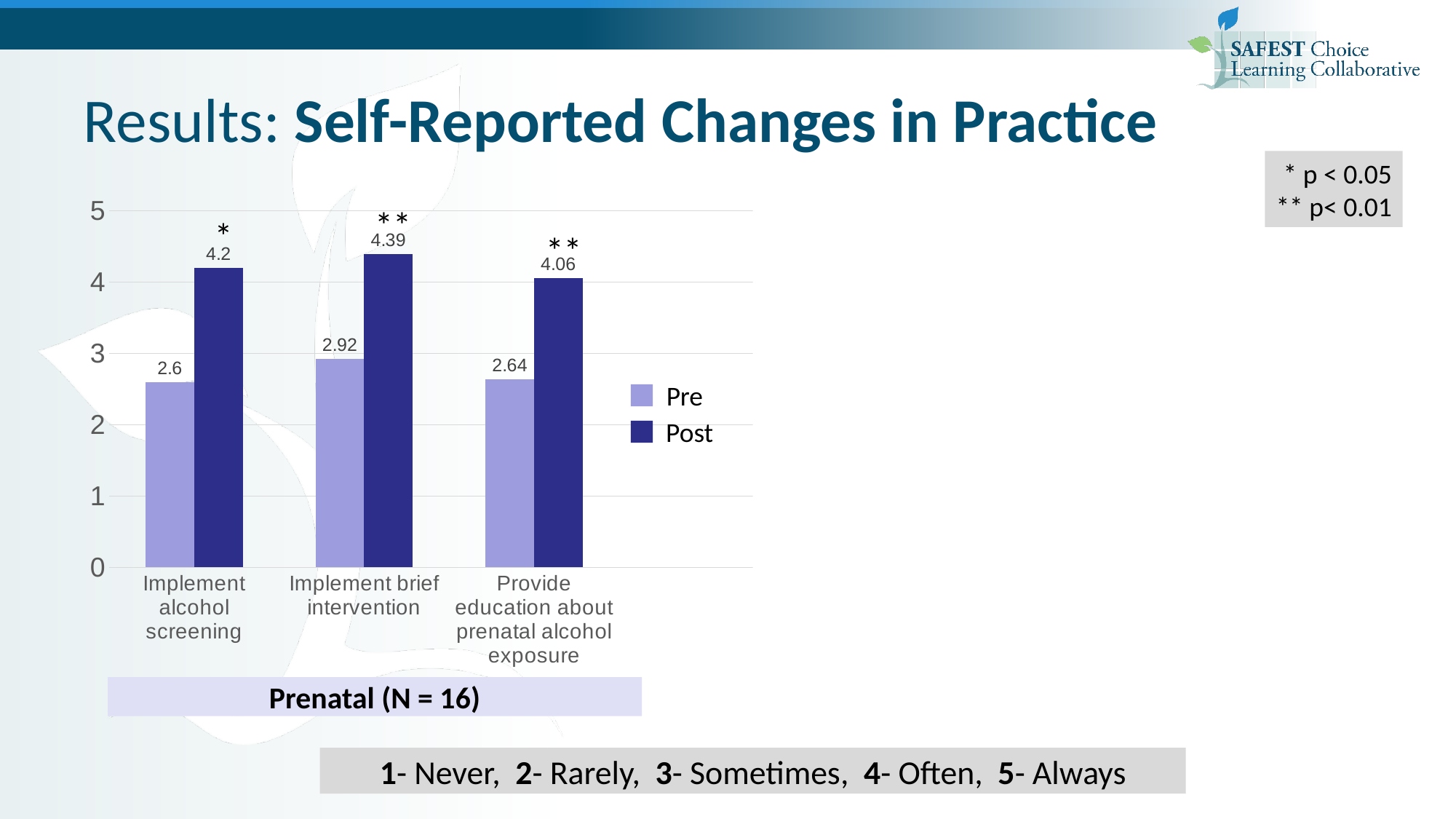
How many series does the legend list? 2 What is the difference between the Post and Pre values for Implement alcohol screening? 1.6 Which category has the lowest Pre value? Implement alcohol screening What is the Post value for Provide education about prenatal alcohol exposure? 4.06 What is the Pre value for Implement alcohol screening? 2.6 Which category has the highest Post value? Implement brief intervention What is the difference between the Post and Pre values for Implement brief intervention? 1.47 What kind of chart is shown on the slide? Bar chart What is the Post value for Implement brief intervention? 4.39 How many categories are shown on the x axis? 3 Which is larger, the Pre value for Implement brief intervention or the Pre value for Provide education about prenatal alcohol exposure? Implement brief intervention What is the Pre value for Provide education about prenatal alcohol exposure? 2.64